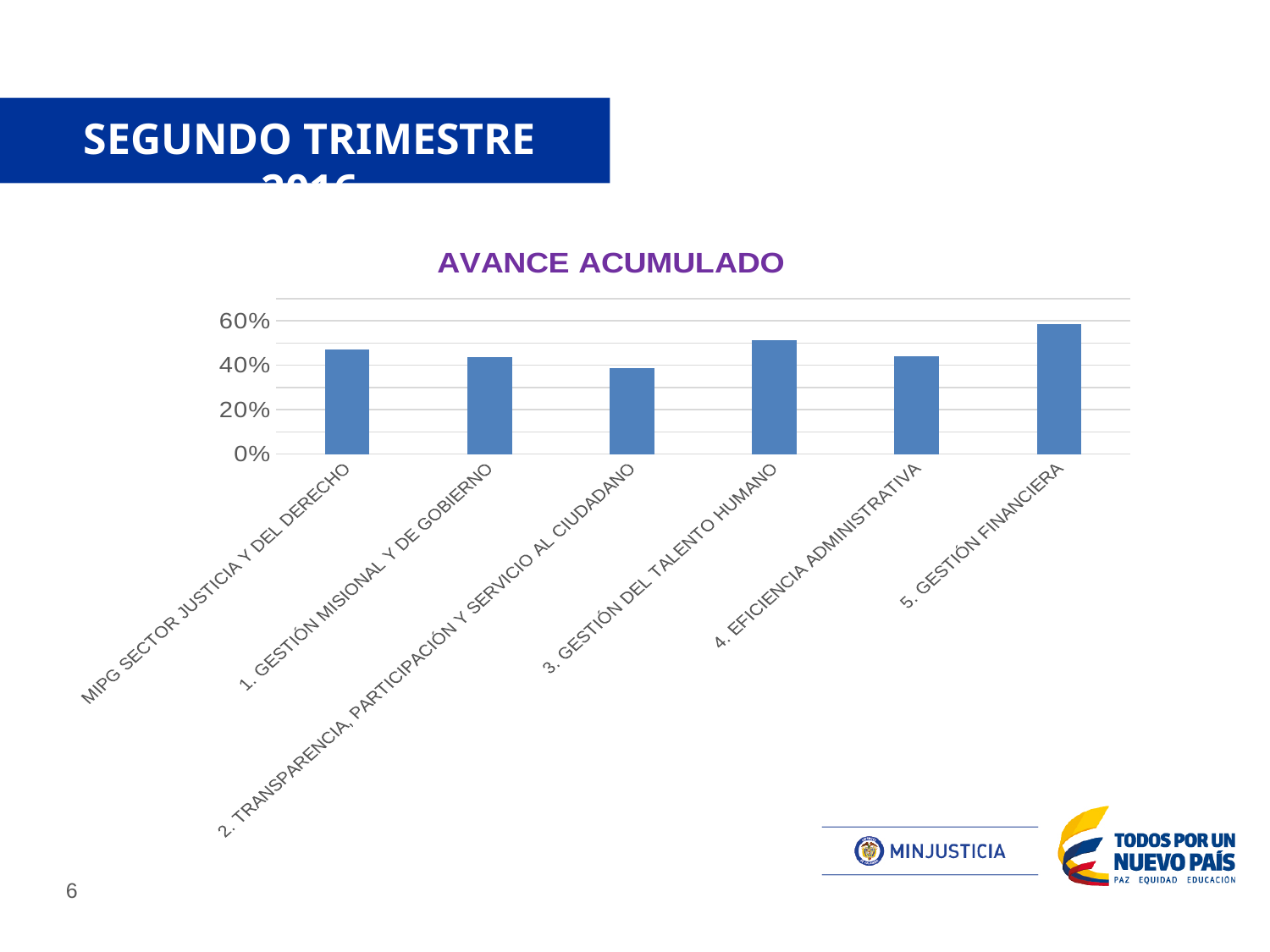
Which category has the highest value? 5. GESTIÓN FINANCIERA Is the value for 2. TRANSPARENCIA, PARTICIPACIÓN Y SERVICIO AL CIUDADANO greater or less than 40%? less Which is larger, the value for 3. GESTIÓN DEL TALENTO HUMANO or the value for 2. TRANSPARENCIA, PARTICIPACIÓN Y SERVICIO AL CIUDADANO? 3. GESTIÓN DEL TALENTO HUMANO What is the title of the chart? AVANCE ACUMULADO Which category has the lowest value? 2. TRANSPARENCIA, PARTICIPACIÓN Y SERVICIO AL CIUDADANO Is the value for MIPG SECTOR JUSTICIA Y DEL DERECHO greater or less than 20%? greater What kind of chart is shown on the slide? bar chart Is the value for 5. GESTIÓN FINANCIERA greater or less than 60%? less Which is larger, the value for 5. GESTIÓN FINANCIERA or the value for MIPG SECTOR JUSTICIA Y DEL DERECHO? 5. GESTIÓN FINANCIERA How many categories are plotted in the chart? 6